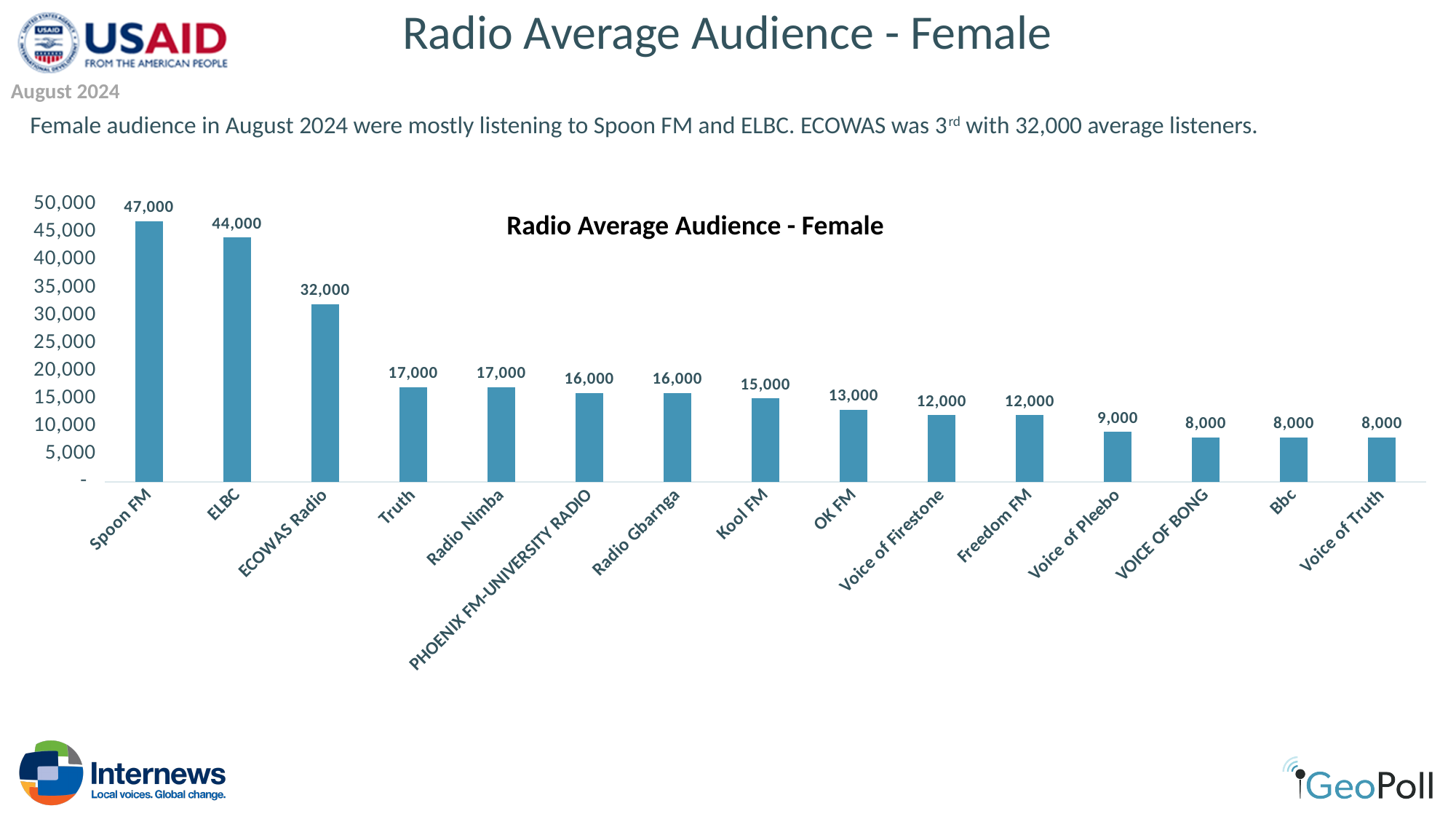
What is the average female audience for Kool FM? 15,000 What is the average female audience for Spoon FM? 47,000 What kind of chart is shown on the slide? Bar chart How many radio stations are shown in the chart? 15 What is the title of the chart? Radio Average Audience - Female What is the difference in average female audience between ECOWAS Radio and Truth? 15,000 Do the values rise or fall moving from left to right along the x axis? Fall What is the average female audience for ECOWAS Radio? 32,000 Which has a larger average female audience, OK FM or Voice of Pleebo? OK FM Is the value for ELBC greater or less than 40,000? greater Which radio station has the highest average female audience? Spoon FM What is the difference in average female audience between Spoon FM and ELBC? 3,000